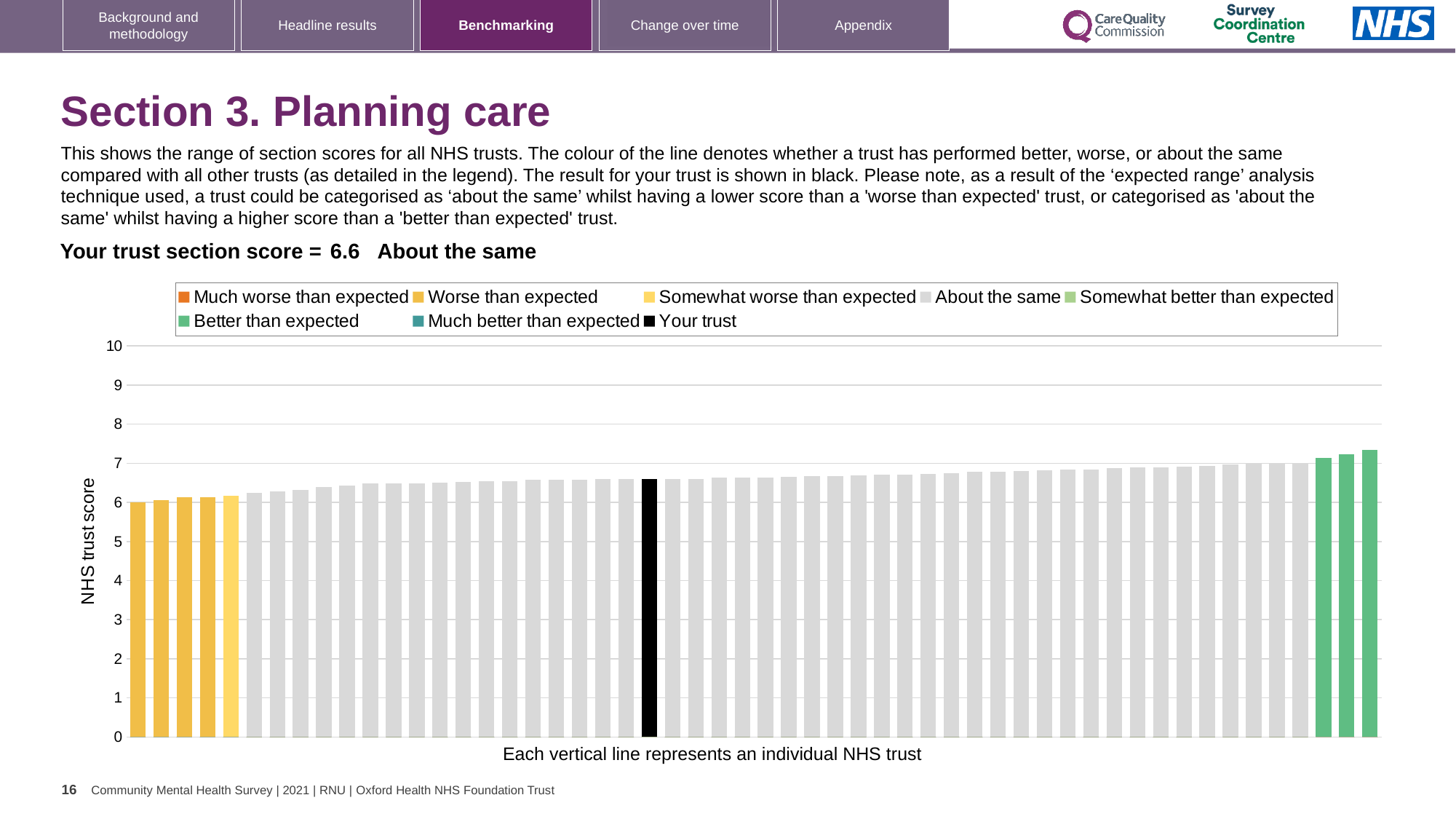
How many bars are coloured green (better than expected)? 3 How many entries does the chart legend list? 8 Is the value of the highest bar in the chart greater or less than 8? less Do the bar values rise or fall from left to right along the x axis? rise What is the section score for your trust shown on the slide? 6.6 Which category is your trust placed in according to the slide? About the same What is the label on the vertical axis of the chart? NHS trust score What kind of chart is shown on the slide? bar chart Is the value for your trust (the black bar) greater or less than 5? greater Is the value of the lowest bar in the chart greater or less than 5? greater How many bars are coloured dark yellow (worse than expected)? 4